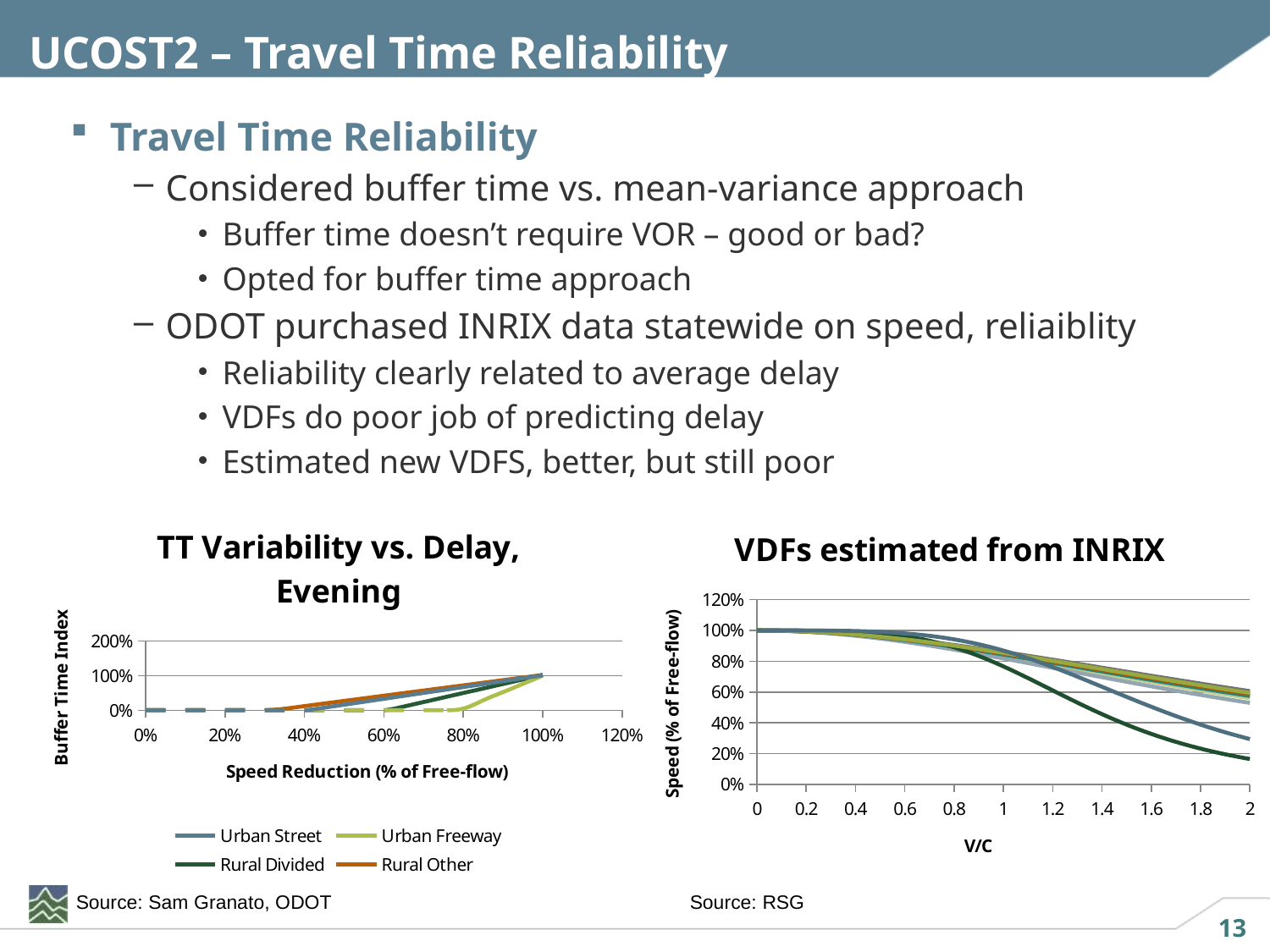
What kind of chart is the 'VDFs estimated from INRIX' chart? line chart In the 'TT Variability vs. Delay, Evening' chart, do the Buffer Time Index values rise or fall as Speed Reduction increases? rise In the 'VDFs estimated from INRIX' chart, what is the Speed (% of Free-flow) value of the lines at V/C = 0? 100% What is the x-axis label of the 'TT Variability vs. Delay, Evening' chart? Speed Reduction (% of Free-flow) In the 'TT Variability vs. Delay, Evening' chart, which series is the last to begin rising above 0% along the x axis? Urban Freeway What is the x-axis label of the 'VDFs estimated from INRIX' chart? V/C In the 'TT Variability vs. Delay, Evening' chart, is the Urban Freeway value at 60% speed reduction greater or less than 100%? less In the 'VDFs estimated from INRIX' chart, is the lowest line's value at V/C = 1.2 greater or less than 80%? less What kind of chart is the 'TT Variability vs. Delay, Evening' chart? line chart In the 'VDFs estimated from INRIX' chart, is the highest line's value at V/C = 2 greater or less than 80%? less How many series does the legend of the 'TT Variability vs. Delay, Evening' chart list? 4 In the 'VDFs estimated from INRIX' chart, do the speed values rise or fall as V/C increases? fall